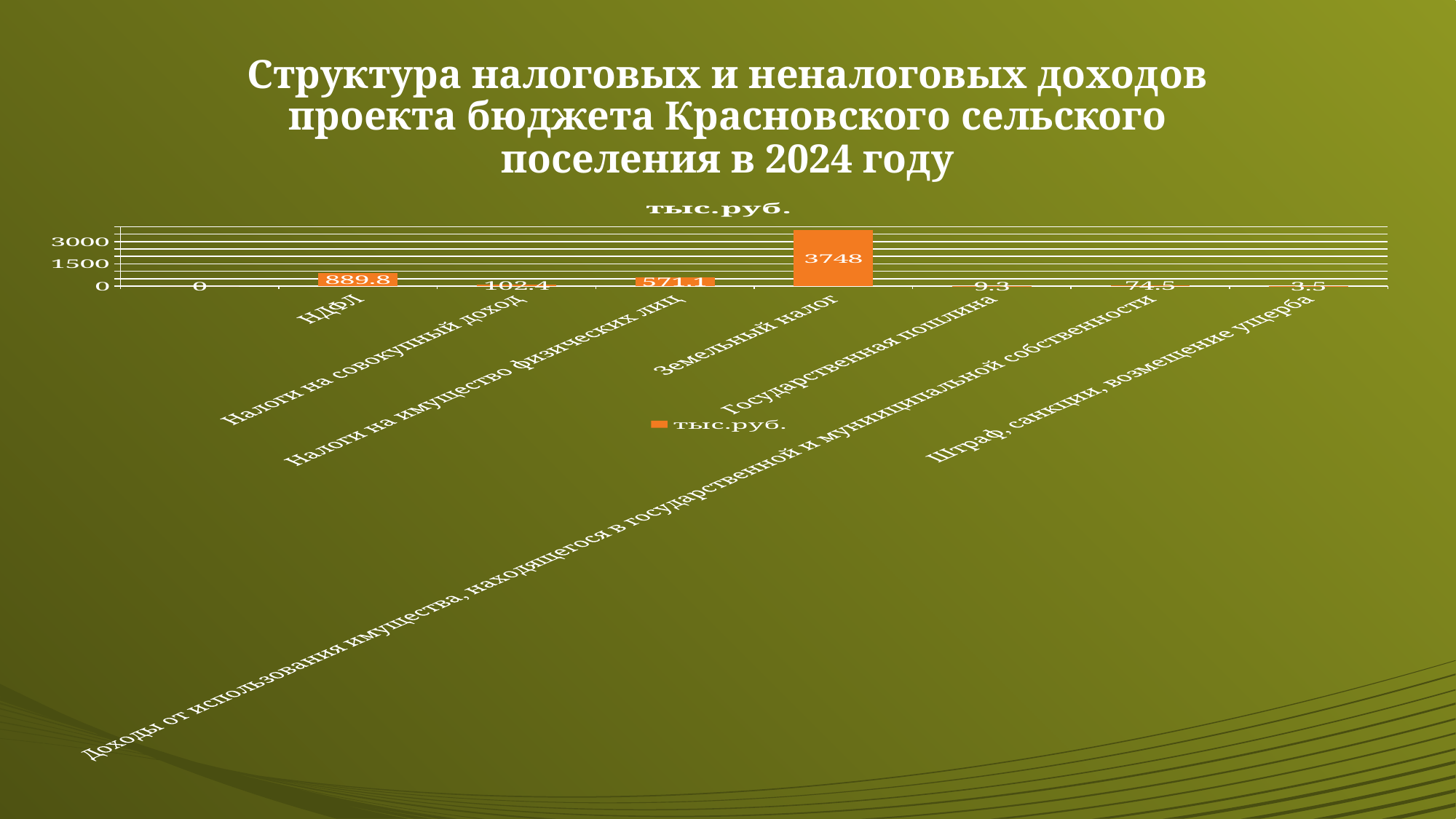
What is the value for Государственная пошлина? 9.3 What is the value for Налоги на имущество физических лиц? 571.1 Which is larger, the value for НДФЛ or the value for Налоги на имущество физических лиц? НДФЛ Which category has the highest value? Земельный налог What is the value for Налоги на совокупный доход? 102.4 What is the difference between the values for Земельный налог and НДФЛ? 2858.2 What is the value for Штраф, санкции, возмещение ущерба? 3.5 Is the value for Земельный налог greater or less than 3000? greater What is the value for Земельный налог? 3748 How many series does the legend list? 1 What is the value for НДФЛ? 889.8 What kind of chart is shown on the slide? bar chart